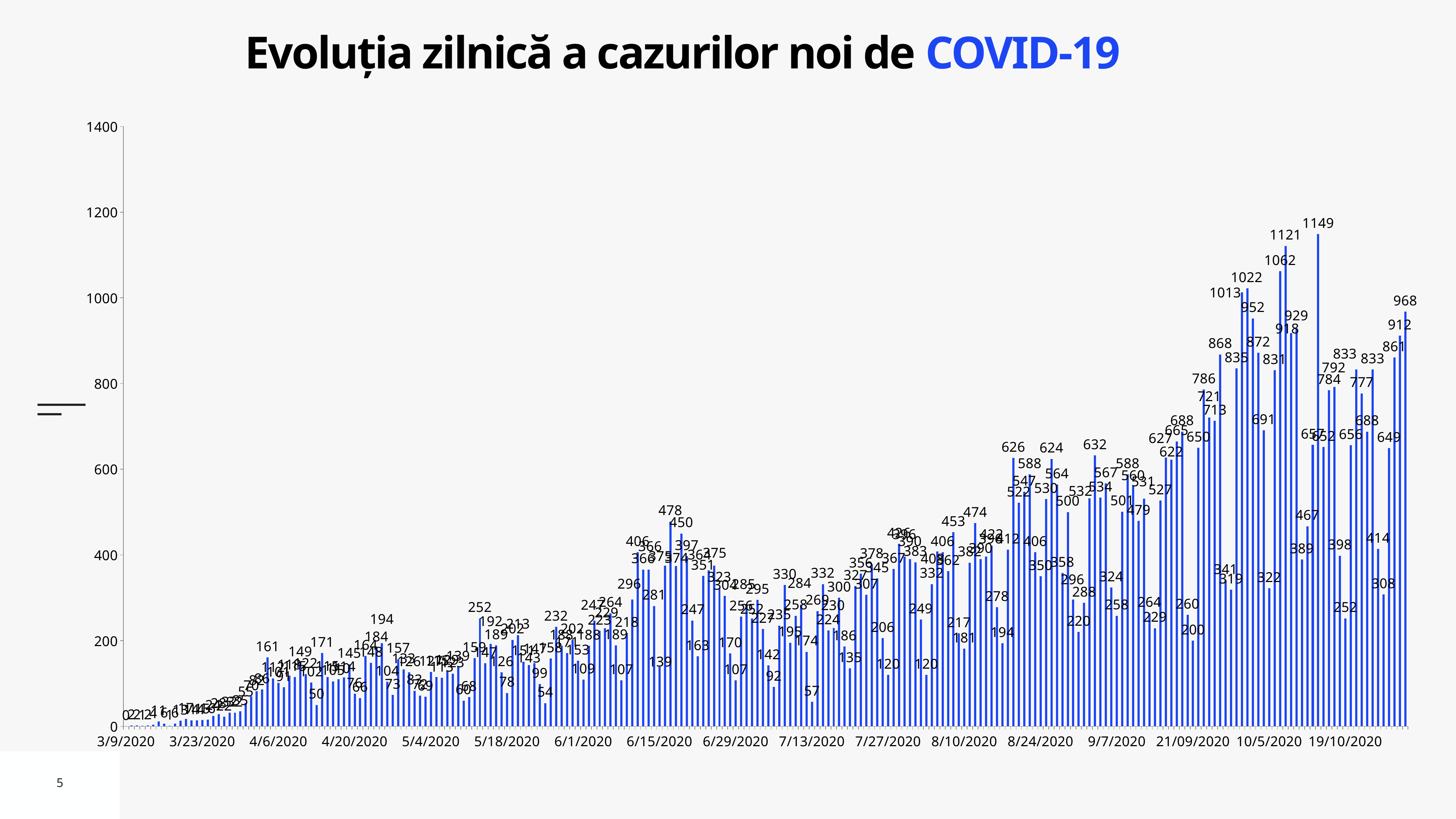
Is the bar labelled 1062 greater or less than 1000? greater What is the maximum value shown on the vertical axis? 1400 Which is larger, the bar labelled 1022 or the bar labelled 952? 1022 What is the title of the chart? Evoluția zilnică a cazurilor noi de COVID-19 What is the difference between the highest labelled value (1149) and the second highest (1121)? 28 What is the highest daily value labelled on the chart? 1149 What is the value labelled on the rightmost bar of the chart? 968 What kind of chart is shown on the slide? bar chart Overall, do the daily values rise or fall from left to right along the x axis? rise Is the highest bar on the chart greater or less than 1200? less Is the value for the first bar at 3/9/2020 greater or less than 200? less What is the first date label shown on the x axis? 3/9/2020